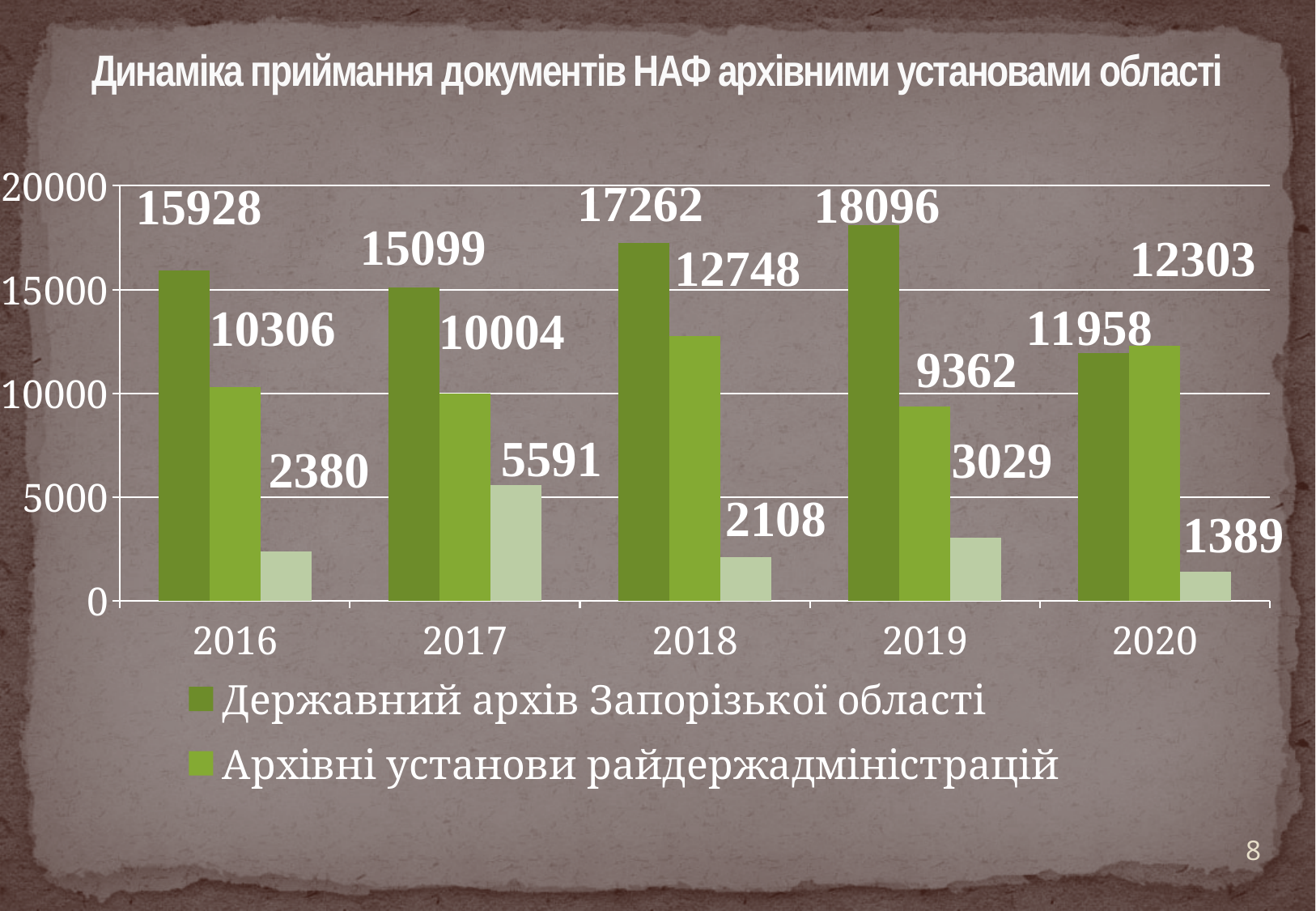
In 2020, which is larger: Державний архів Запорізької області or Архівні установи райдержадміністрацій? Архівні установи райдержадміністрацій What is the difference between Державний архів Запорізької області and Архівні установи райдержадміністрацій in 2016? 5622 In which year is the value for Архівні установи райдержадміністрацій the highest? 2018 What is the value for Державний архів Запорізької області in 2019? 18096 What is the value for Архівні установи райдержадміністрацій in 2018? 12748 How many series does the legend list? 2 In which year is the value for Державний архів Запорізької області the lowest? 2020 In which year is the value for Державний архів Запорізької області the highest? 2019 How many years are shown on the x axis? 5 What is the value of the lightest green bar for 2017? 5591 Does the value for Державний архів Запорізької області rise or fall from 2016 to 2017? fall What kind of chart is shown on the slide? bar chart